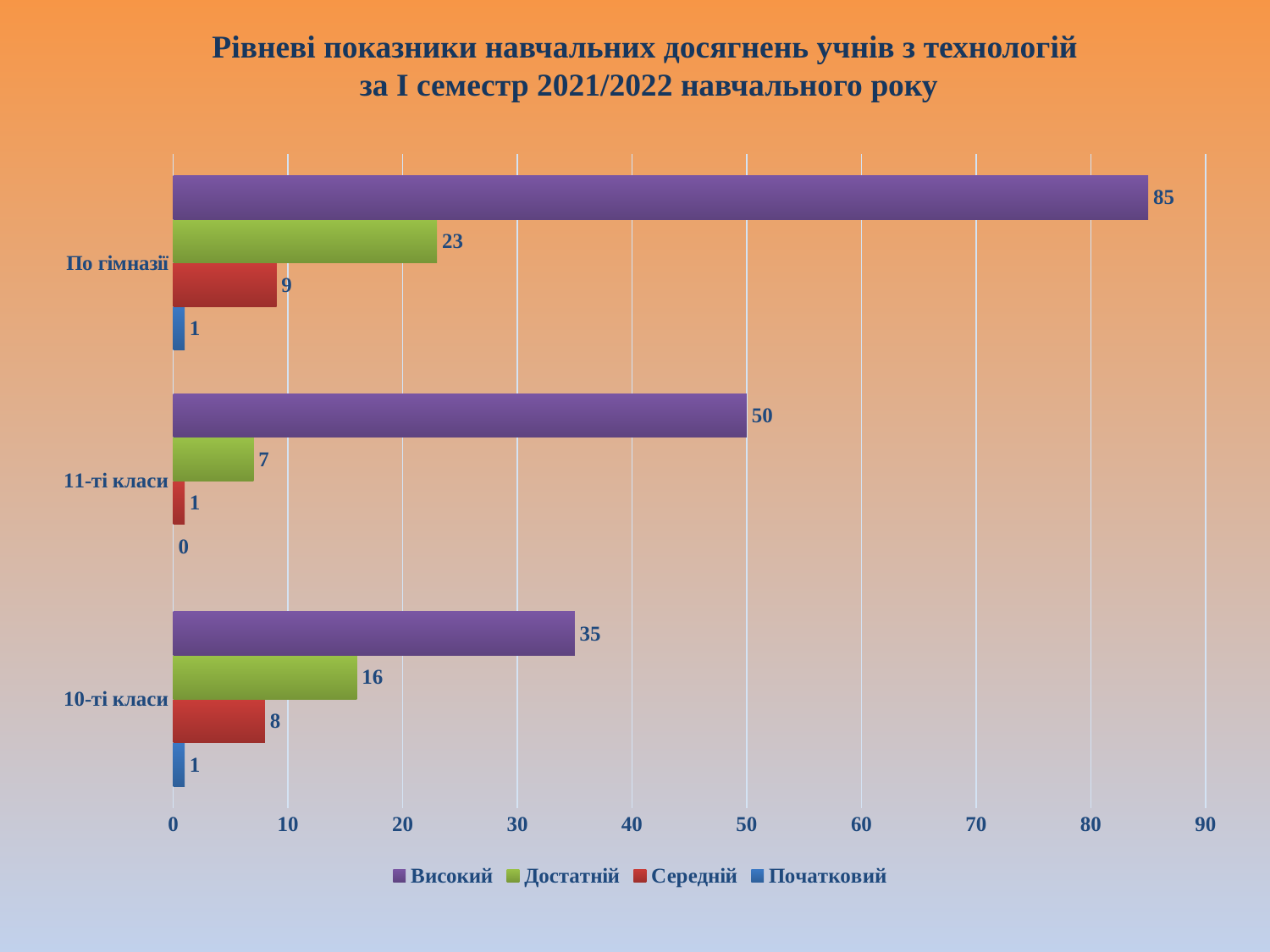
Which category has the highest Високий value? По гімназії What is the value for Середній for 11-ті класи? 1 What is the value for Високий for По гімназії? 85 What kind of chart is shown on the slide? bar chart What is the value for Початковий for 11-ті класи? 0 Which series is shown in purple? Високий How many series does the legend list? 4 How many categories are shown on the y axis? 3 What is the difference between the Високий values for 11-ті класи and 10-ті класи? 15 What is the value for Достатній for 10-ті класи? 16 Which category has the lowest Достатній value? 11-ті класи Which is larger: the Середній value for По гімназії or for 10-ті класи? По гімназії